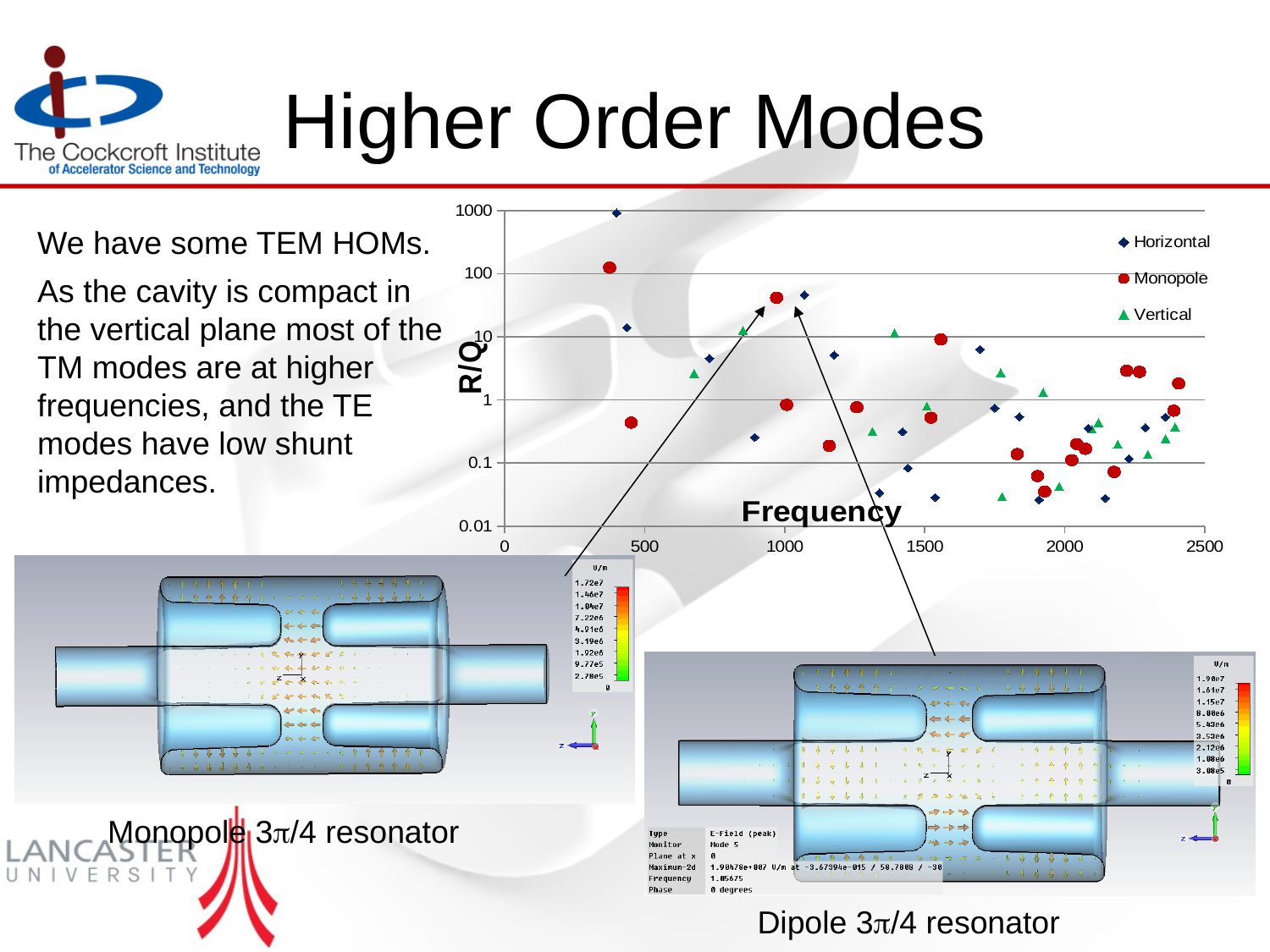
What are the three series named in the chart legend? Horizontal, Monopole, Vertical Is the highest R/Q value for the Horizontal series greater or less than 100? greater What kind of chart is shown on the slide? Scatter chart Is the lowest R/Q value for the Horizontal series greater or less than 0.1? less Is the highest R/Q value for the Vertical series greater or less than 100? less Which series has the higher maximum R/Q value, Monopole or Vertical? Monopole How many series does the chart legend list? 3 What is the label on the chart's vertical axis? R/Q Which series contains the point with the highest R/Q value on the chart? Horizontal Do the R/Q values on the chart generally rise or fall as frequency increases? fall